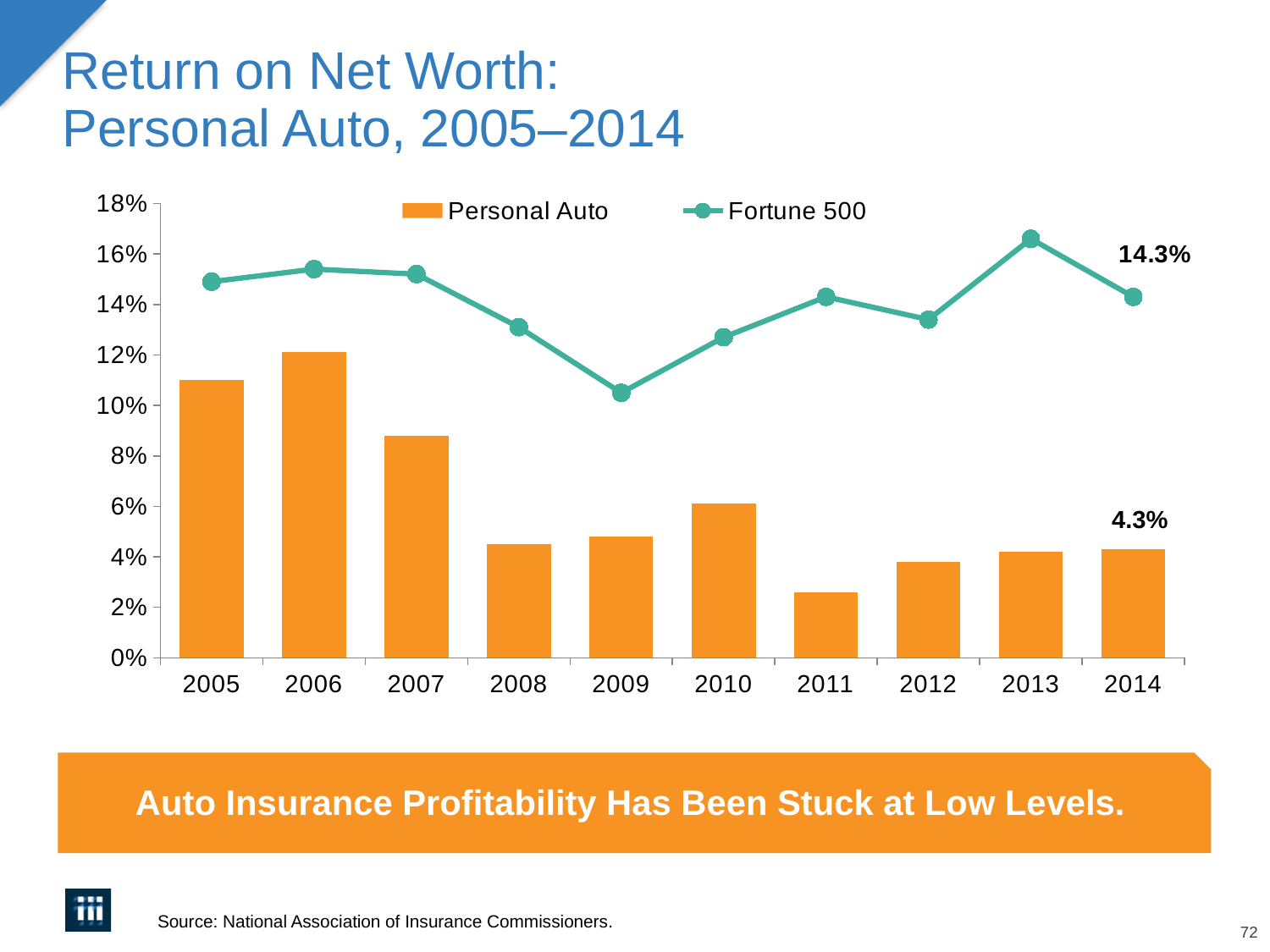
In which year is the Personal Auto return on net worth lowest? 2011 In which year is the Fortune 500 return on net worth lowest? 2009 What is the Fortune 500 return on net worth in 2014? 14.3% Is the Personal Auto value for 2005 greater or less than 10%? greater In which year is the Personal Auto return on net worth highest? 2006 Which is larger, the Personal Auto value for 2006 or for 2007? 2006 Is the Fortune 500 value for 2013 greater or less than 16%? greater What is the Personal Auto return on net worth in 2014? 4.3% How many years are shown on the x axis? 10 In 2014, how much higher is the Fortune 500 value than the Personal Auto value? 10.0% How many series does the legend list? 2 Do the Personal Auto values rise or fall from 2005 to 2008? fall